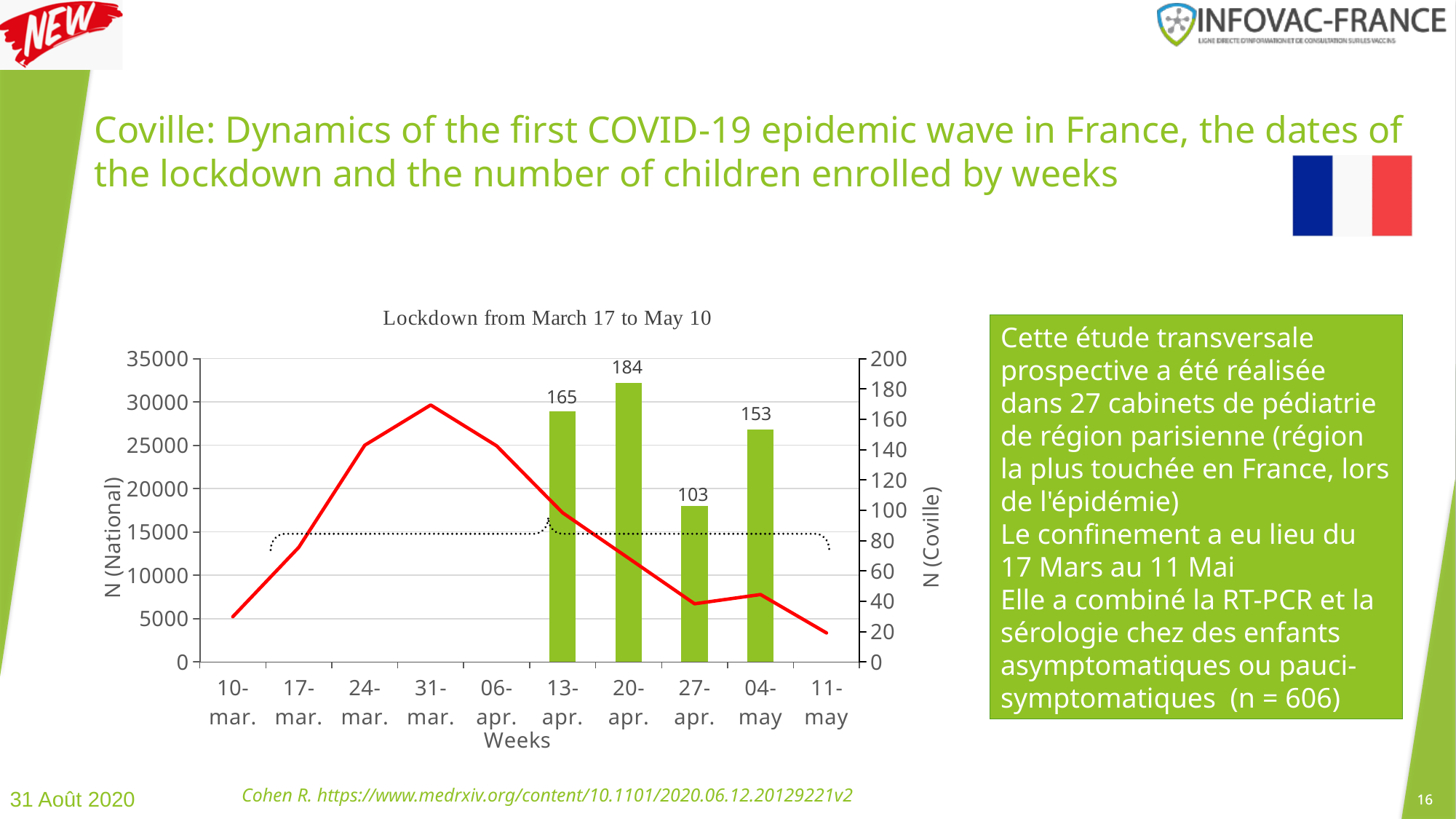
Is the national value (red line) for the week of 10-mar. greater or less than 10000? less Is the national value (red line) for the week of 31-mar. greater or less than 25000? greater Which week has more children enrolled, 13-apr. or 04-may? 13-apr. What is the number of children enrolled (N Coville) in the week of 20-apr.? 184 Which week has the highest number of children enrolled (green bars)? 20-apr. What is the difference between the number of children enrolled in the week of 20-apr. and the week of 27-apr.? 81 Does the national value (red line) rise or fall from the week of 31-mar. to the week of 11-may? fall What is the number of children enrolled (N Coville) in the week of 27-apr.? 103 How many weeks are shown on the x axis of the chart? 10 Which week has the lowest number of children enrolled among the green bars? 27-apr. What is the title of the chart? Lockdown from March 17 to May 10 What is the number of children enrolled (N Coville) in the week of 04-may? 153